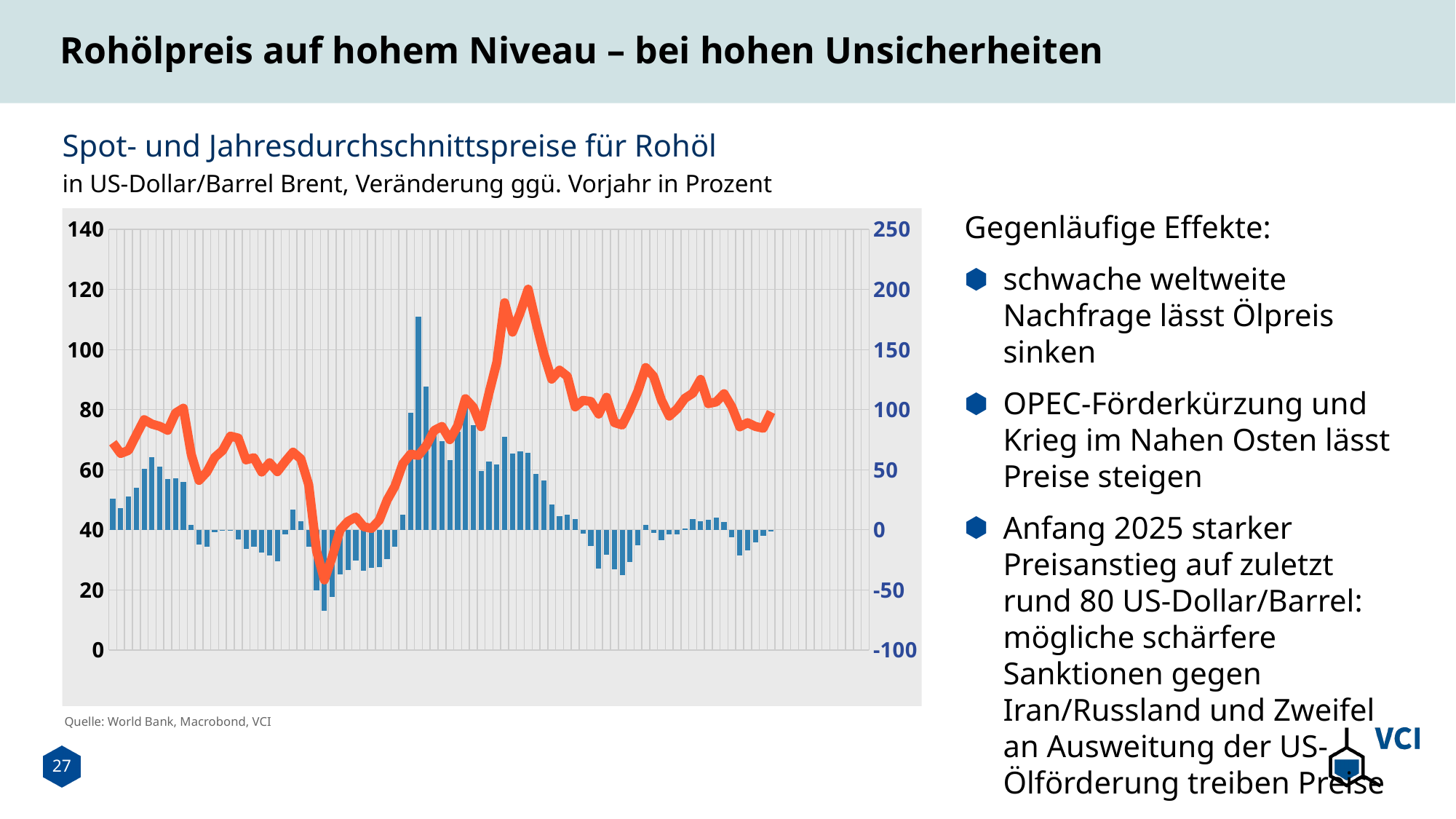
Is the peak of the orange line greater or less than 100 on the left axis? greater What source is given for the chart? World Bank, Macrobond, VCI Is the lowest blue bar greater or less than -50 on the right axis? less Is the last value of the orange line at the right edge of the chart greater or less than 100 on the left axis? less What is the lowest value shown on the right vertical axis of the chart? -100 What is the highest value shown on the left vertical axis of the chart? 140 What kind of chart is shown on the slide? A combined line and bar chart How many data series are plotted in the chart? 2